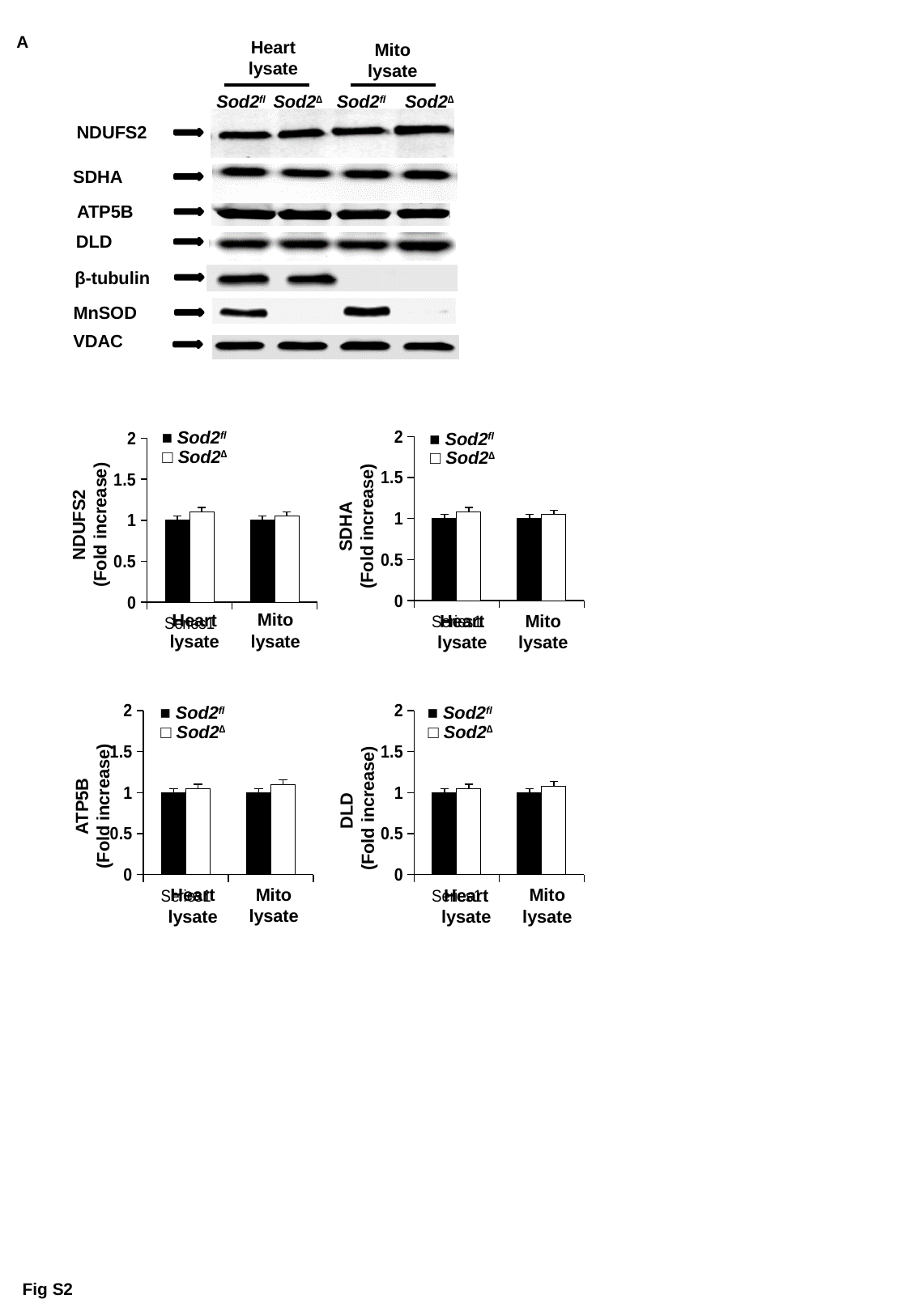
What are the two x-axis categories in the NDUFS2 chart? Heart lysate and Mito lysate In the DLD chart, is the value for Sod2fl in Heart lysate greater or less than 0.5? greater In the ATP5B chart, is the value for Sod2Δ in Mito lysate greater or less than 1.5? less How many categories are shown on the x axis of the ATP5B chart? 2 What are the two series named in the legend of the DLD chart? Sod2fl and Sod2Δ In the NDUFS2 chart, is the value for Sod2Δ in Heart lysate greater or less than 1.5? less What is the y-axis label of the SDHA chart? SDHA (Fold increase) What kind of chart is the NDUFS2 chart? bar chart How many bar charts are shown on the slide? 4 How many series does the legend of the SDHA chart list? 2